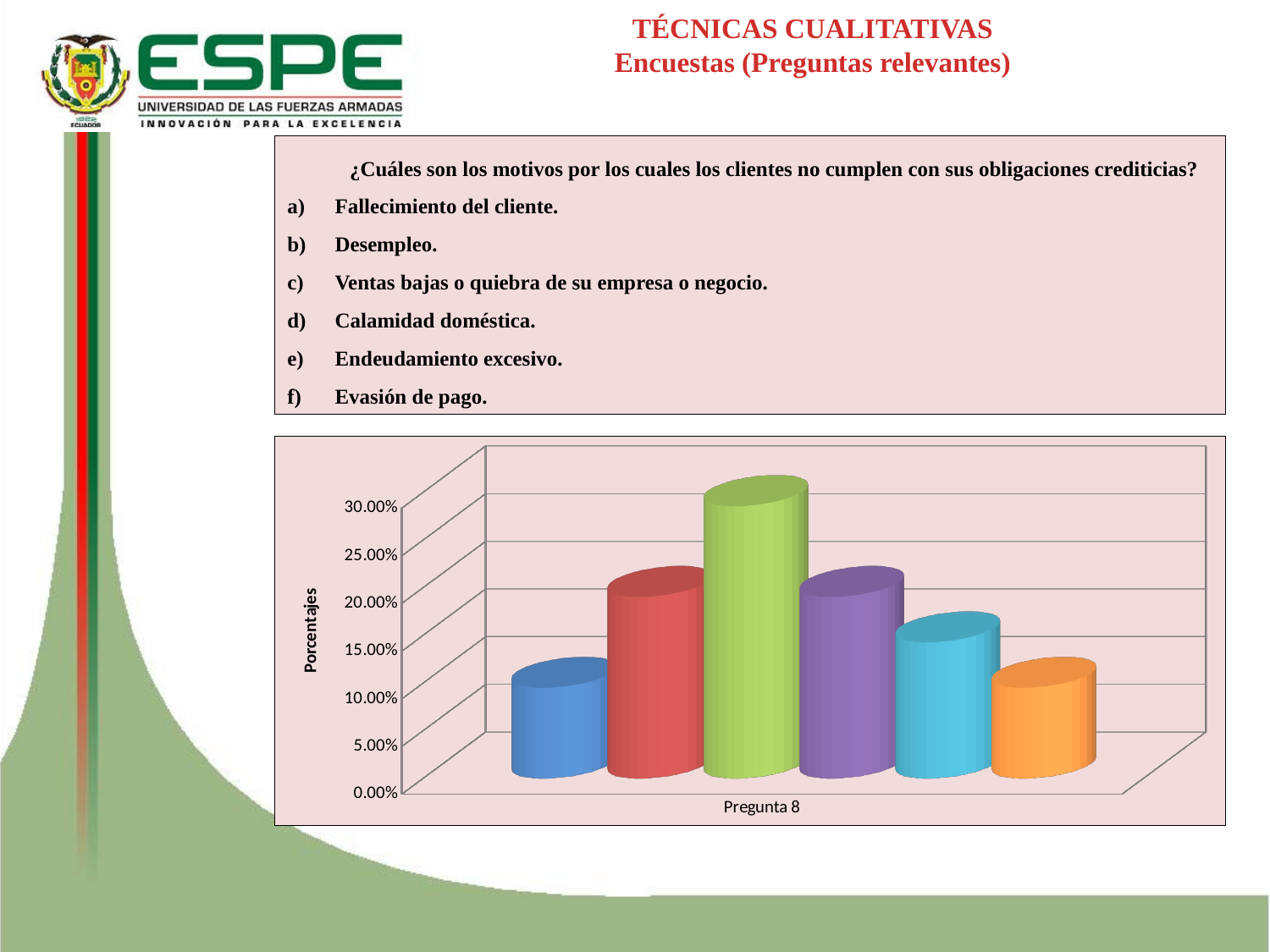
Is the value of the red bar (second from left) greater or less than 15.00%? greater How many bars are plotted in the chart? 6 Which bar is the tallest in the chart? the green bar (third from left) Is the value of the blue bar (first from left) greater or less than 15.00%? less Is the value of the green bar greater or less than 25.00%? greater Which is larger, the red bar or the light blue bar? the red bar Which is larger, the green bar or the purple bar? the green bar What label appears on the horizontal axis of the chart? Pregunta 8 What kind of chart is shown on the slide? bar chart What is the title of the vertical axis of the chart? Porcentajes